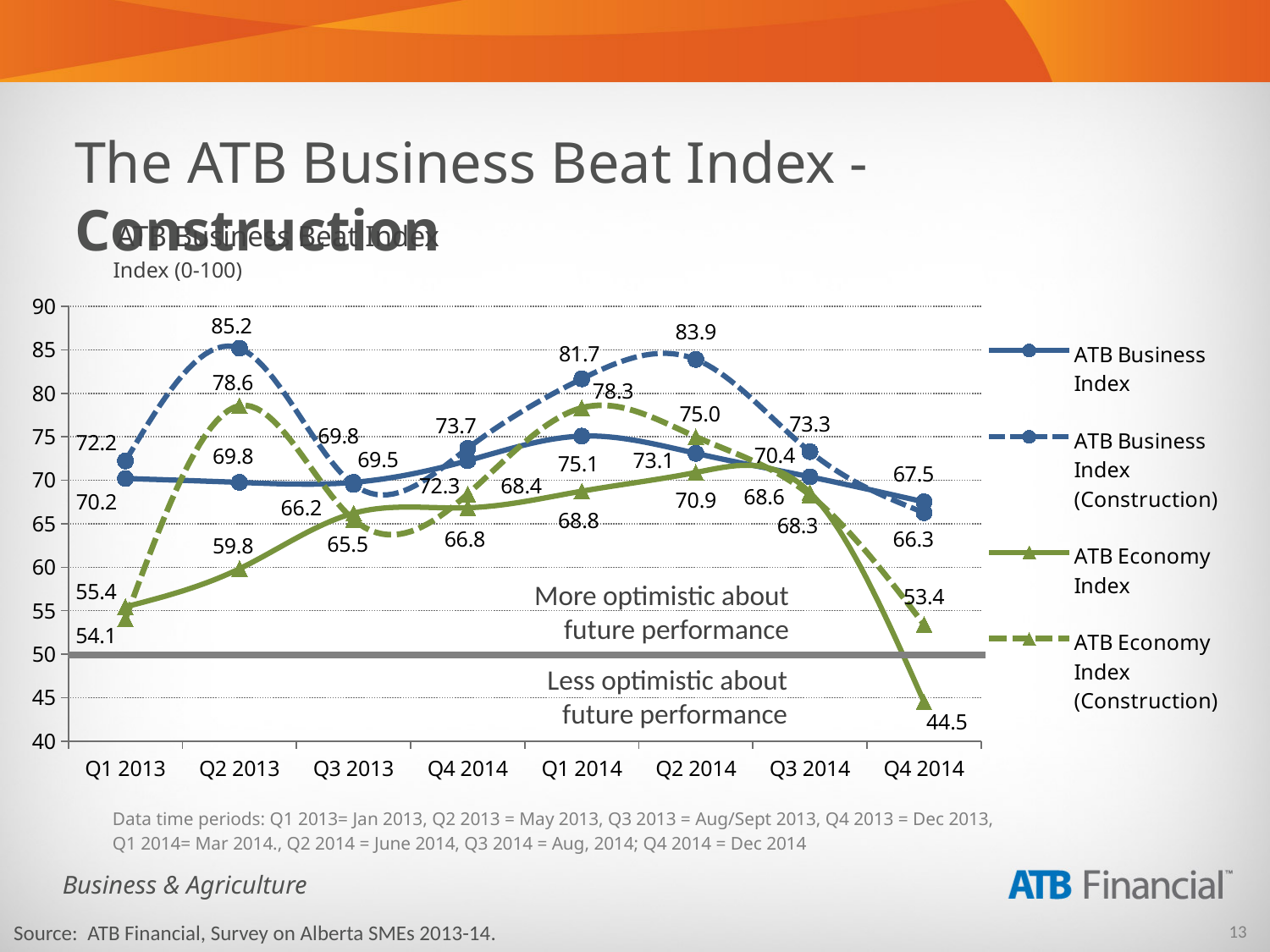
How many time periods are plotted along the x axis? 8 What is the value of the ATB Business Index (Construction) in Q2 2014? 83.9 In which period does the ATB Business Index (Construction) reach its highest value? Q2 2013 What is the difference between the ATB Business Index (Construction) values in Q2 2013 and Q2 2014? 1.3 What is the value of the ATB Business Index in Q1 2014? 75.1 How many series does the legend list? 4 What is the value of the ATB Economy Index in Q4 2014? 44.5 Is the ATB Economy Index value for Q4 2014 greater or less than 50? less Does the ATB Economy Index (Construction) rise or fall from Q2 2014 to Q4 2014? Fall What is the value of the ATB Business Index (Construction) in Q2 2013? 85.2 In which period does the ATB Economy Index reach its lowest value? Q4 2014 What kind of chart is shown on the slide? Line chart